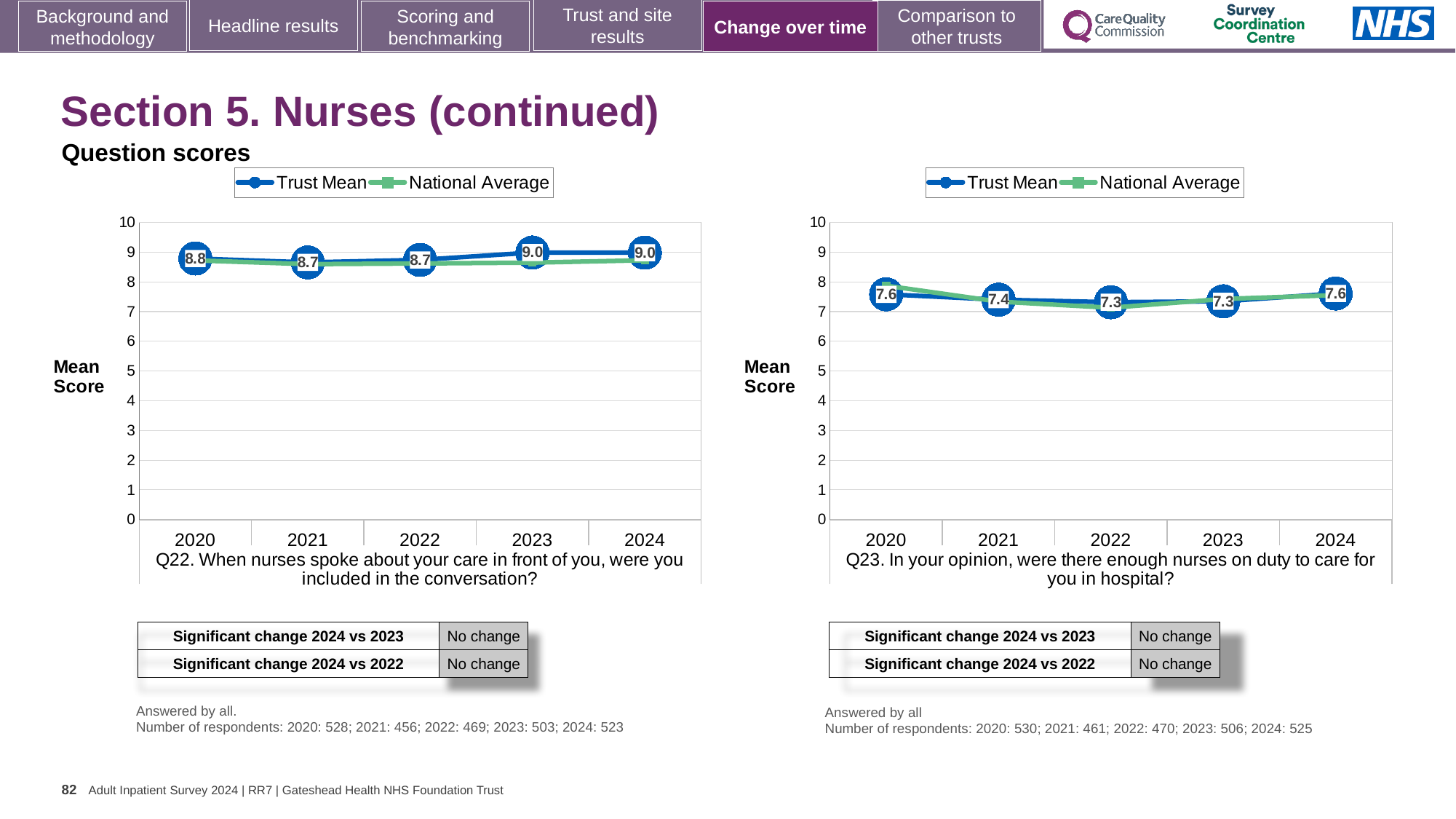
How many series does the legend of the Q23 chart (right) list? 2 In the Q23 chart (right), what is the Trust Mean score for 2024? 7.6 What kind of chart is the Q22 chart (left)? Line chart In the Q22 chart (left), what is the Trust Mean score for 2020? 8.8 In the Q23 chart (right), is the Trust Mean value for 2021 greater or less than 8? less In the Q22 chart (left), which year has the lowest Trust Mean score? 2021 and 2022 (both 8.7) In the Q22 chart (left), what does the legend say the blue line represents? Trust Mean In the Q23 chart (right), what is the difference between the Trust Mean score in 2024 and in 2022? 0.3 How many years are plotted on the x axis of the Q22 chart (left)? 5 In the Q22 chart (left), is the Trust Mean score for 2021 greater or less than the Trust Mean score for 2023? less In the Q22 chart (left), what is the Trust Mean score for 2024? 9.0 In the Q23 chart (right), what is the Trust Mean score for 2022? 7.3